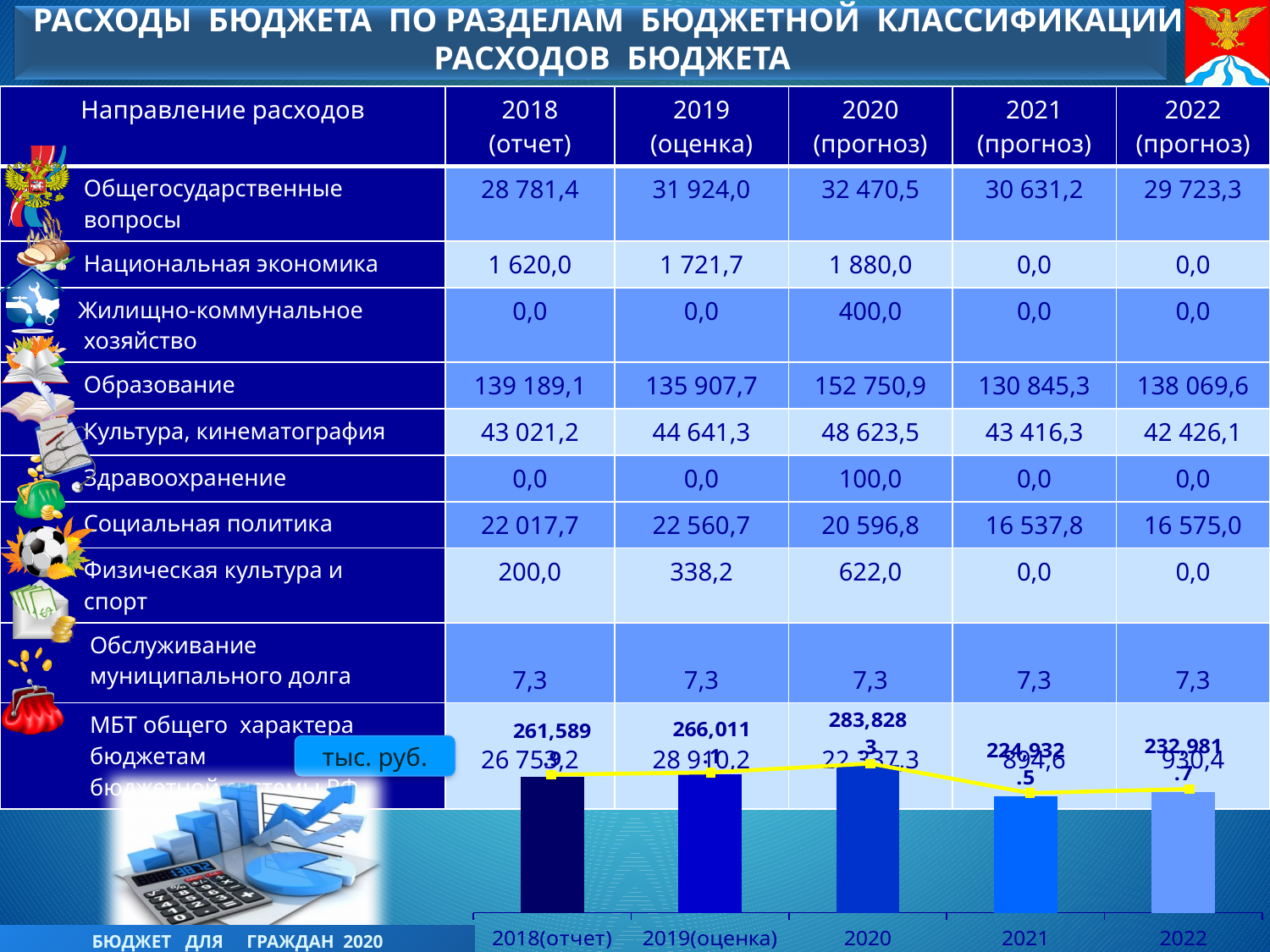
What colour is the line drawn across the tops of the bars in the chart at the bottom of the slide? yellow In the bar chart at the bottom of the slide, what is the value for 2018(отчет)? 261,589.9 In the bar chart at the bottom of the slide, which year has the highest value? 2020 In the bar chart at the bottom of the slide, which year has the lowest value? 2021 In the bar chart at the bottom of the slide, which is larger: the value for 2018(отчет) or for 2019(оценка)? 2019(оценка) In the bar chart at the bottom of the slide, what is the value for 2020? 283,828.3 In the bar chart at the bottom of the slide, does the value rise or fall from 2020 to 2021? fall How many bars (years) are shown in the bar chart at the bottom of the slide? 5 In the bar chart at the bottom of the slide, what is the difference between the values for 2019(оценка) and 2018(отчет)? 4,421.2 In the bar chart at the bottom of the slide, does the value rise or fall from 2021 to 2022? rise What kind of chart is shown at the bottom of the slide? bar chart In the bar chart at the bottom of the slide, what is the value for 2019(оценка)? 266,011.1